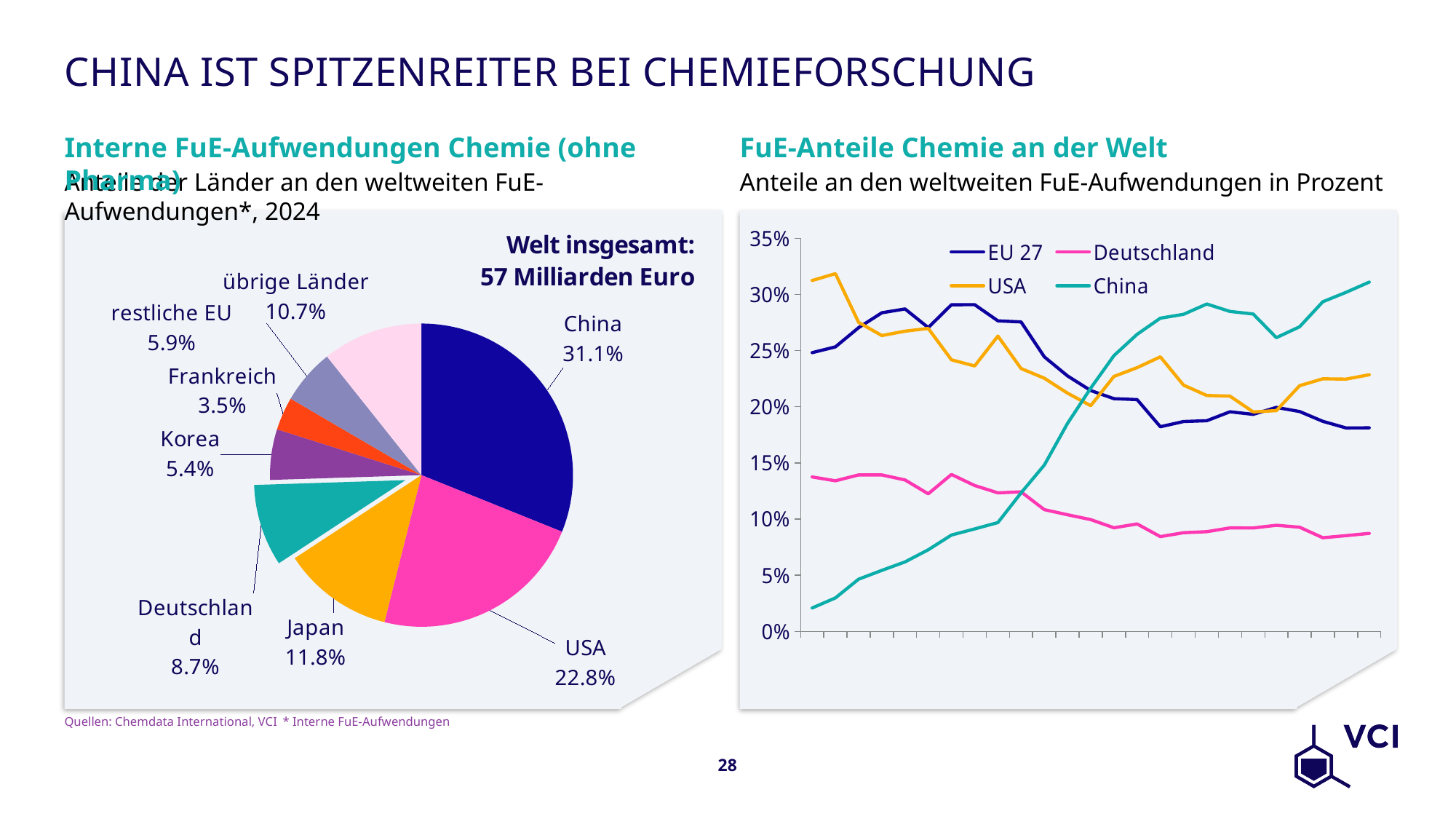
In the pie chart on the left, what is the difference in percentage points between the shares of China and the USA? 8.3 What kind of chart is the chart on the right, 'FuE-Anteile Chemie an der Welt'? line chart In the line chart on the right, does the China line rise or fall along the x axis? rise In the pie chart on the left, which labelled slice has the smallest share? Frankreich In the line chart on the right, is the final value for Deutschland greater or less than 10%? less In the pie chart on the left, which has the larger share, Korea or restliche EU? restliche EU In the pie chart on the left, what is the share for Japan? 11.8% In the pie chart on the left, how many slices are there? 8 In the pie chart on the left, what is the total worldwide R&D spending stated on the chart? 57 Milliarden Euro In the line chart on the right, how many series does the legend list? 4 In the pie chart on the left, which country has the largest share? China In the pie chart on the left, what share of worldwide chemical R&D spending does China account for? 31.1%